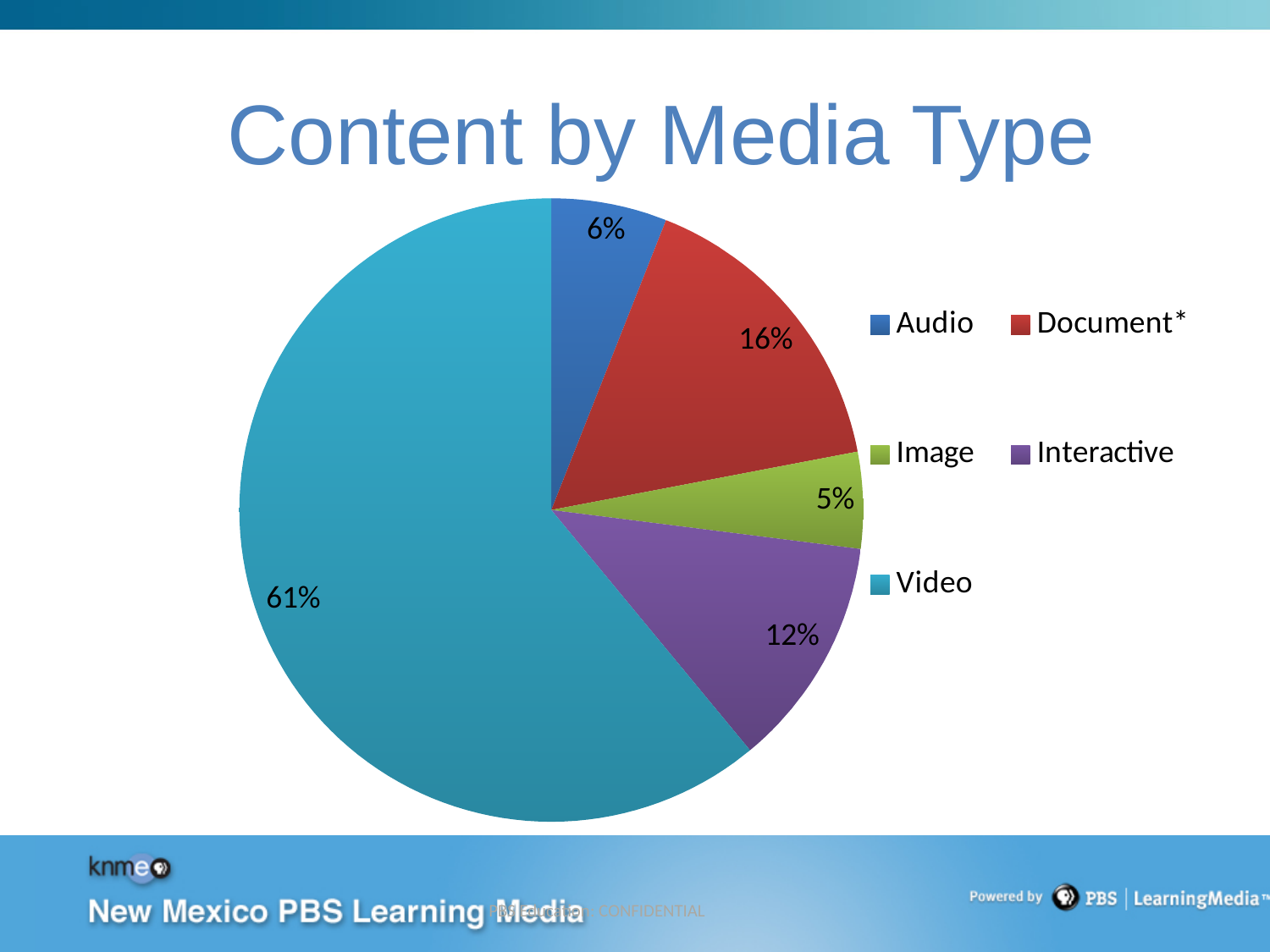
What share of content is Image? 5% What share of content is Interactive? 12% Which media type has the largest share of content? Video What share of content is Audio? 6% Which has a larger share, Interactive or Audio? Interactive What is the difference in percentage points between the Video share and the Document* share? 45 How many media types are shown in the pie chart? 5 What is the title of the chart? Content by Media Type What share of content is Video? 61% What kind of chart is shown on the slide? Pie chart Which media type has the smallest share of content? Image What share of content is Document*? 16%